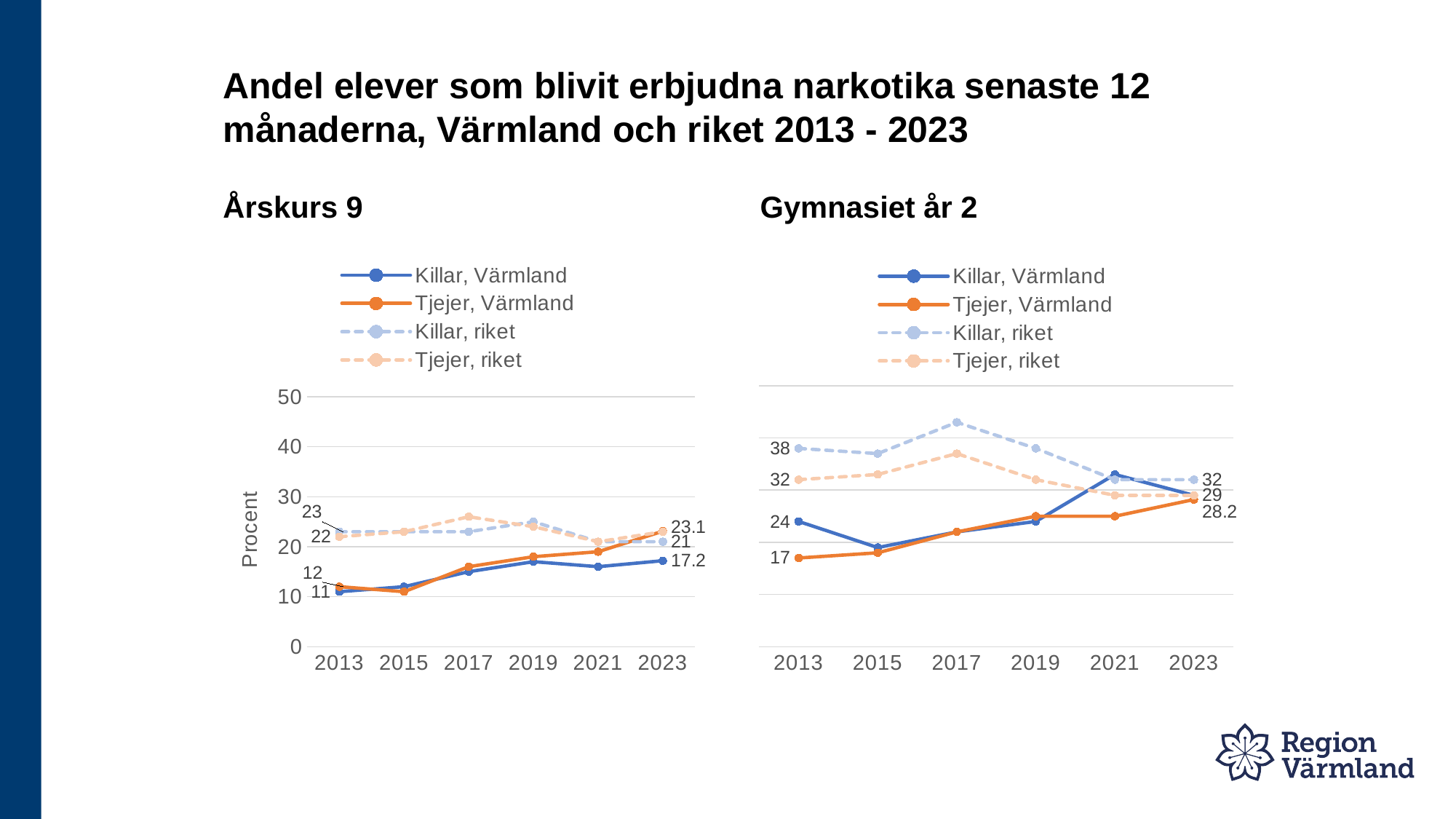
What is the label on the y axis of the Årskurs 9 chart? Procent In the Gymnasiet år 2 chart, is the value for Killar, riket in 2017 greater or less than 40? greater In the Årskurs 9 chart, what is the value for Killar, Värmland in 2023? 17.2 In the Gymnasiet år 2 chart, which series has the highest value in 2013? Killar, riket In the Årskurs 9 chart, by how much did the value for Killar, Värmland change from 2013 (11) to 2023 (17.2)? 6.2 What type of chart is used for Årskurs 9? Line chart In the Gymnasiet år 2 chart, what is the value for Killar, riket in 2013? 38 In the Årskurs 9 chart, what is the value for Killar, Värmland in 2013? 11 How many years are shown on the x axis of the Årskurs 9 chart? 6 In the Årskurs 9 chart, what is the value for Tjejer, Värmland in 2023? 23.1 How many series does the legend of the Gymnasiet år 2 chart list? 4 In the Gymnasiet år 2 chart, what is the value for Tjejer, Värmland in 2023? 28.2